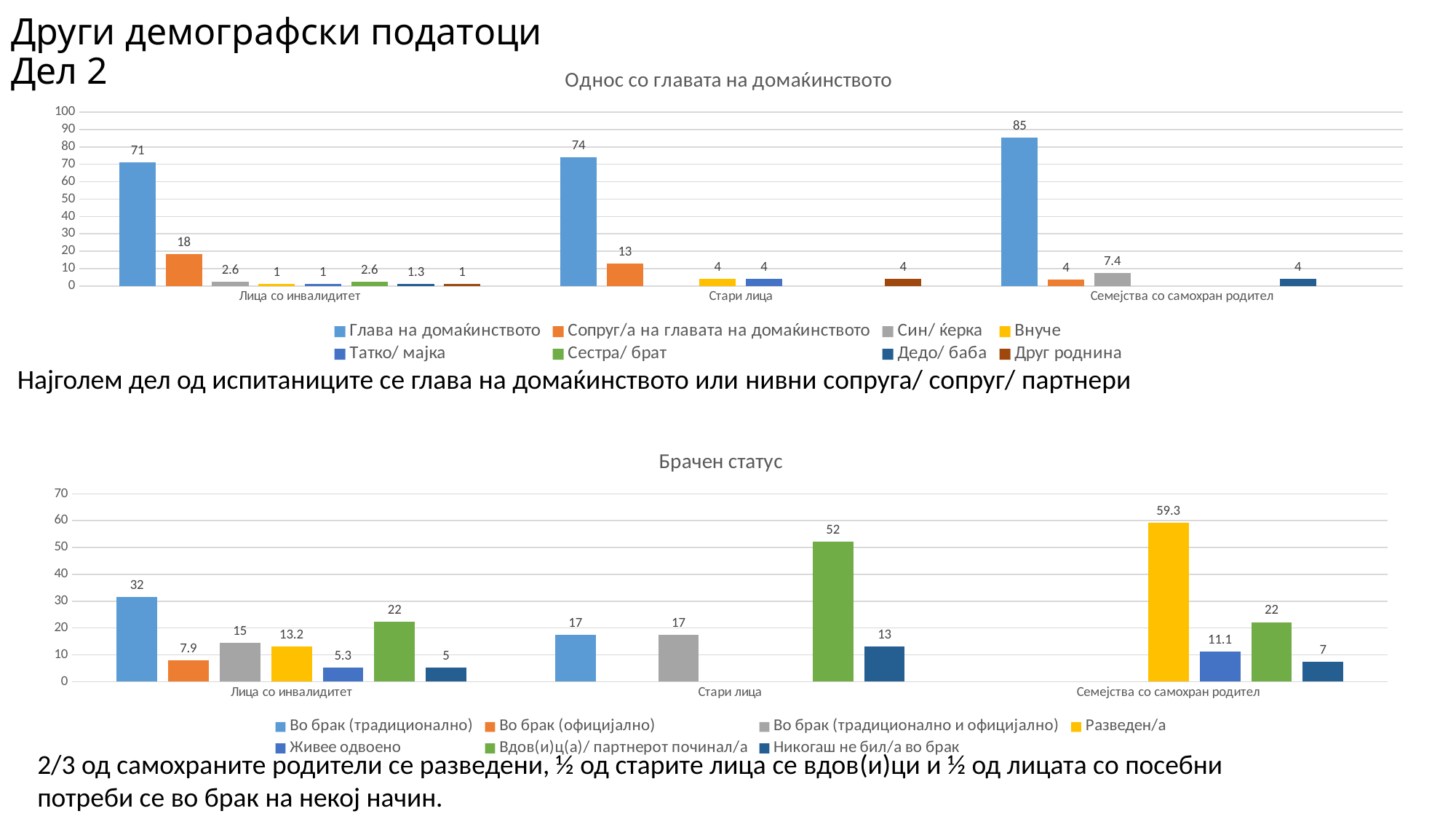
In the chart titled "Однос со главата на домаќинството", what is the difference between the "Глава на домаќинството" values for "Стари лица" and "Лица со инвалидитет"? 3 In the chart titled "Брачен статус", what is the value for "Разведен/а" in the "Семејства со самохран родител" category? 59.3 What kind of chart is the chart titled "Брачен статус"? Bar chart In the chart titled "Однос со главата на домаќинството", what is the value for "Сопруг/а на главата на домаќинството" in the "Лица со инвалидитет" category? 18 In the chart titled "Брачен статус", what is the value for "Вдов(и)ц(а)/ партнерот починал/а" in the "Стари лица" category? 52 In the chart titled "Однос со главата на домаќинството", how many series does the legend list? 8 In the chart titled "Брачен статус", which is larger for "Лица со инвалидитет": "Во брак (традиционално)" or "Вдов(и)ц(а)/ партнерот починал/а"? Во брак (традиционално) In the chart titled "Брачен статус", how many categories are shown on the x axis? 3 In the chart titled "Брачен статус", what is the difference between "Во брак (традиционално и официјално)" and "Во брак (официјално)" for "Лица со инвалидитет"? 7.1 In the chart titled "Однос со главата на домаќинството", what is the value for "Глава на домаќинството" in the "Семејства со самохран родител" category? 85 In the chart titled "Однос со главата на домаќинството", what is the value for "Син/ ќерка" in the "Семејства со самохран родител" category? 7.4 In the chart titled "Однос со главата на домаќинството", which category has the highest value for "Глава на домаќинството"? Семејства со самохран родител